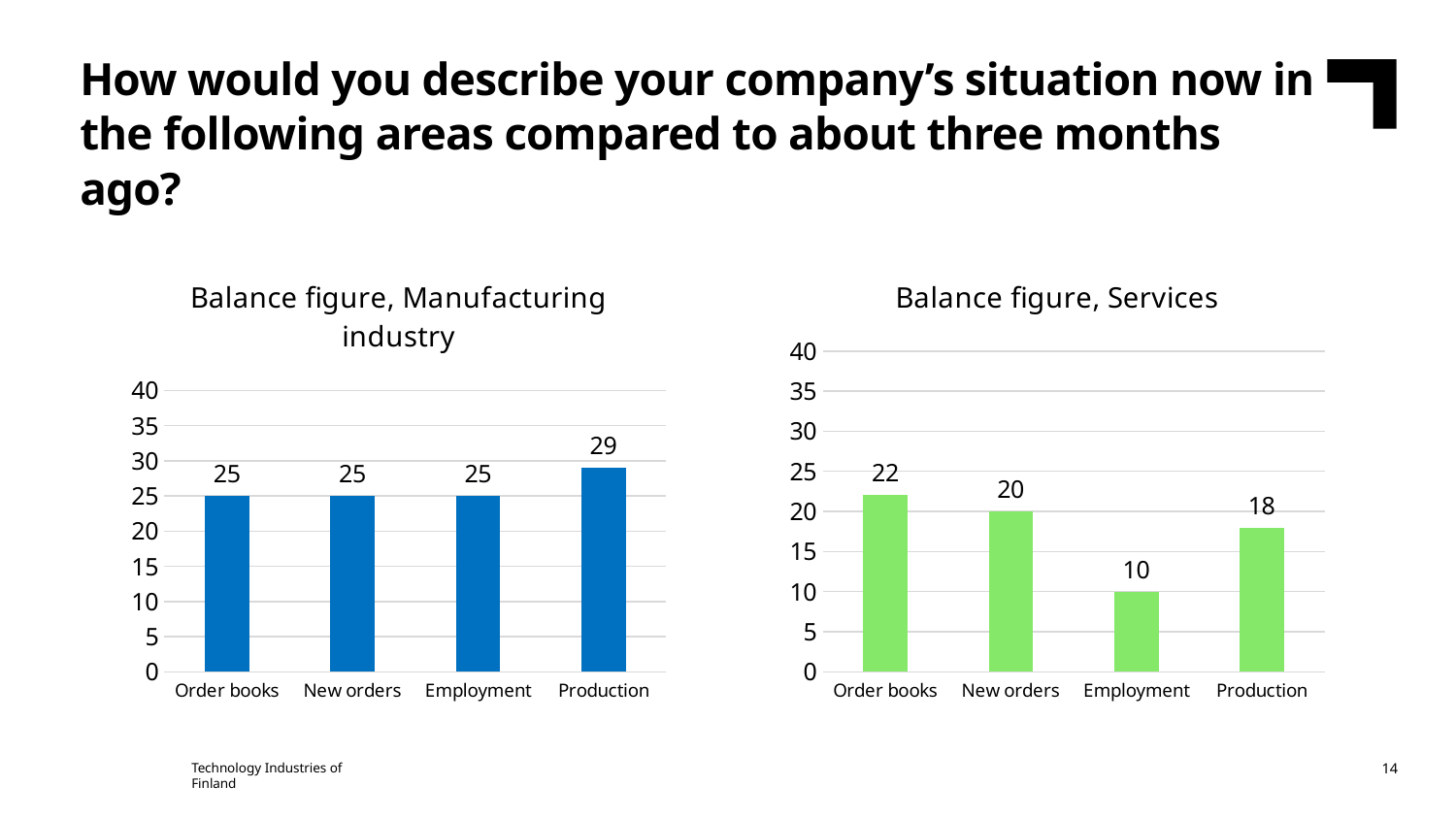
In the 'Balance figure, Manufacturing industry' chart, what is the value for Production? 29 In the 'Balance figure, Manufacturing industry' chart, which category has the highest value? Production In the 'Balance figure, Services' chart, what is the value for Employment? 10 In the 'Balance figure, Manufacturing industry' chart, what is the difference between the values for Production and New orders? 4 How many categories are shown in the 'Balance figure, Services' chart? 4 What colour are the bars in the 'Balance figure, Services' chart? Green In the 'Balance figure, Services' chart, which category has the lowest value? Employment In the 'Balance figure, Services' chart, what is the difference between the values for Order books and Employment? 12 Which is larger: the value for Production in the 'Balance figure, Manufacturing industry' chart or the value for Production in the 'Balance figure, Services' chart? Manufacturing industry In the 'Balance figure, Services' chart, what is the value for Order books? 22 In the 'Balance figure, Services' chart, which category has the highest value? Order books What kind of chart is the 'Balance figure, Manufacturing industry' chart? Bar chart